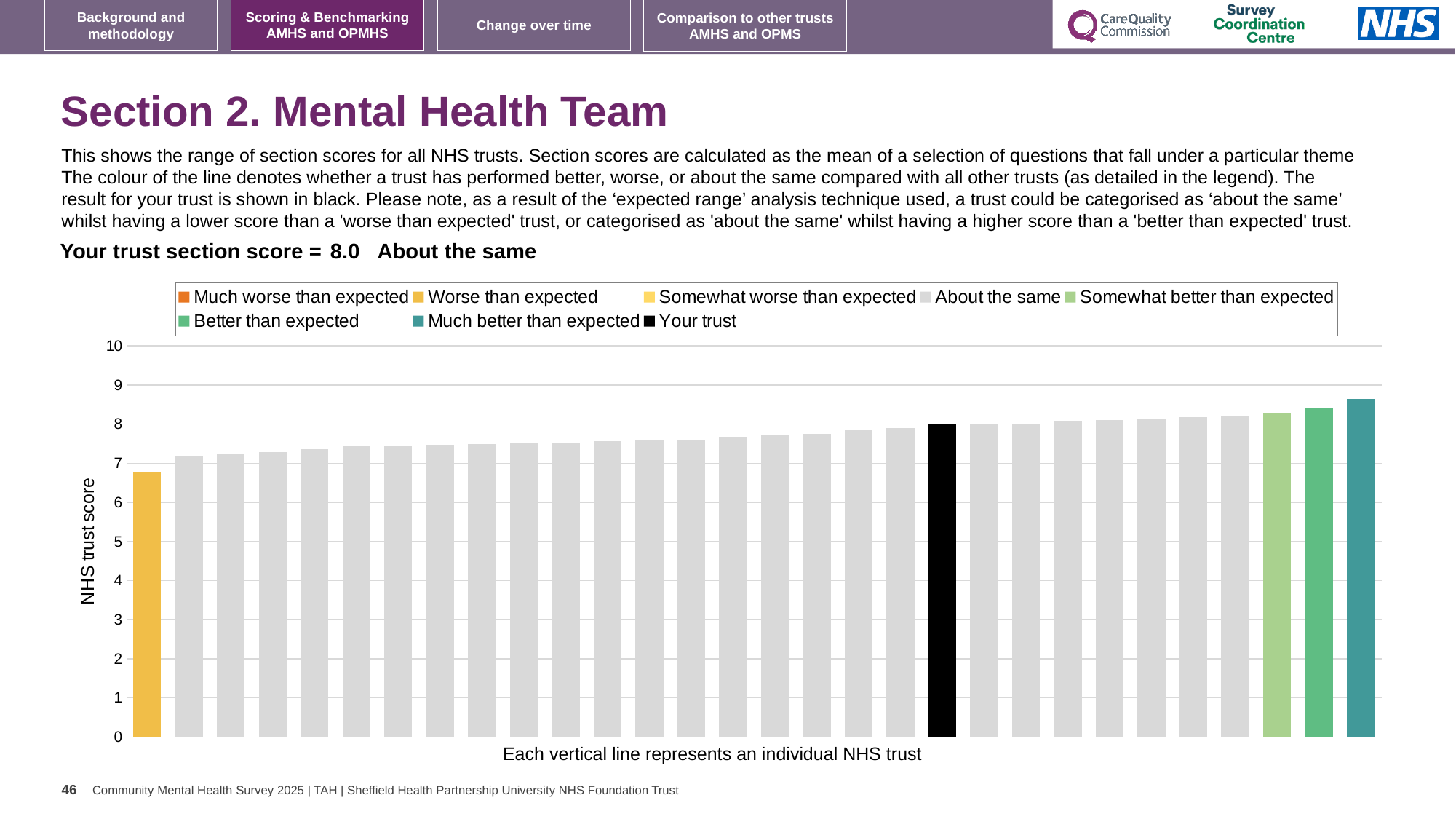
Do the bar values rise or fall from left to right across the chart? Rise Which category is your trust's section score placed in? About the same What colour is the bar representing your trust? Black What is the label on the vertical axis of the chart? NHS trust score What kind of chart is shown on the slide? Bar chart How many entries does the chart legend list? 8 Is the value of the rightmost bar greater or less than 8? greater How many bars are coloured as 'Worse than expected'? 1 Is the value of the black 'Your trust' bar greater or less than 9? less What is the section score for your trust shown on the slide? 8.0 How many bars (NHS trusts) are plotted in the chart? 30 Is the value of the leftmost bar greater or less than 7? less